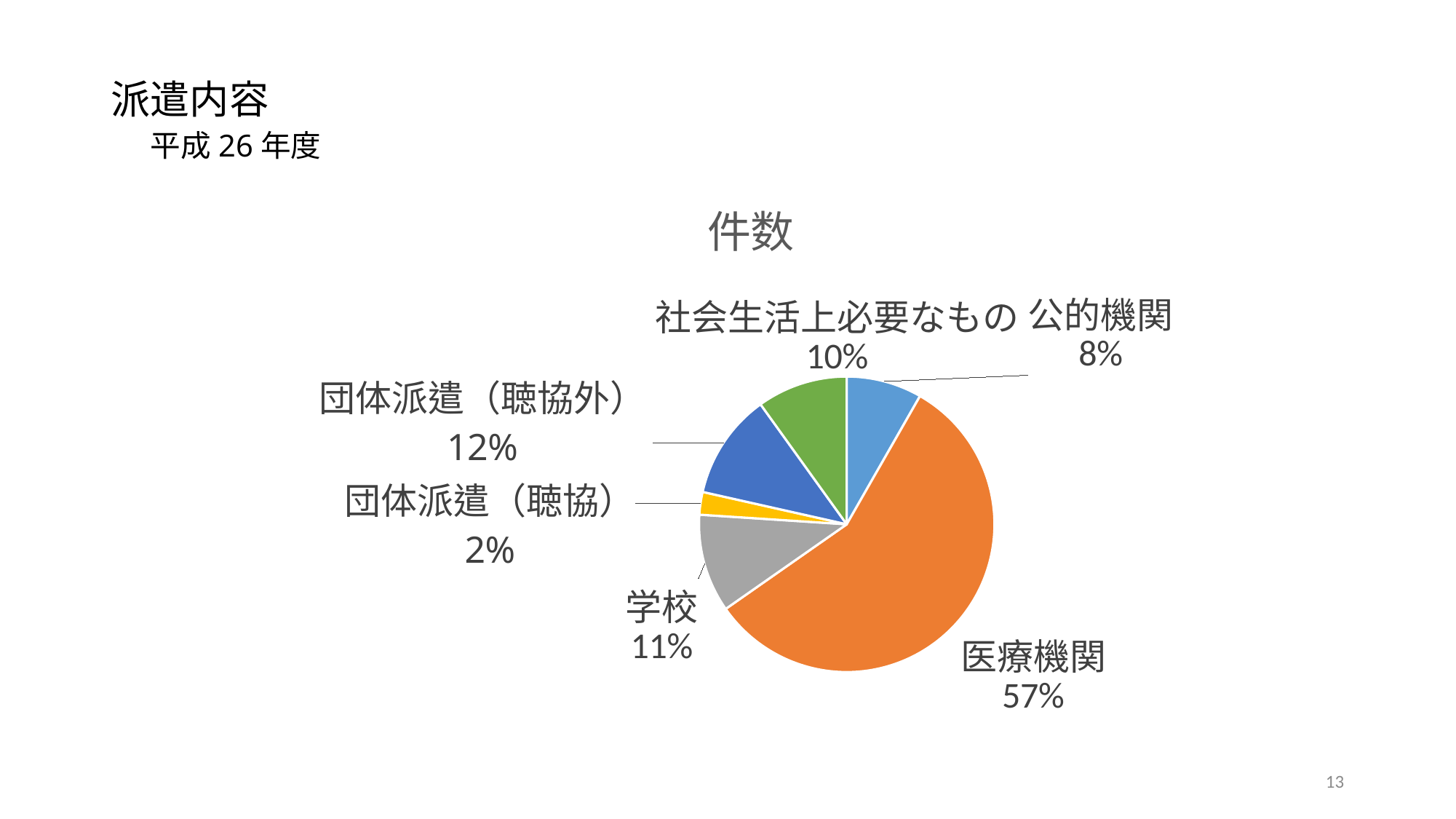
What share of the pie does 医療機関 have? 57% What share of the pie does 公的機関 have? 8% Which is larger, the share for 団体派遣（聴協外） or the share for 公的機関? 団体派遣（聴協外） Which category has the largest slice of the pie? 医療機関 What is the chart's title? 件数 What share of the pie does 団体派遣（聴協外） have? 12% What is the difference in percentage points between 医療機関 and 学校? 46 Which category has the smallest slice of the pie? 団体派遣（聴協） How many categories are shown in the pie chart? 6 What kind of chart is shown on the slide? pie chart